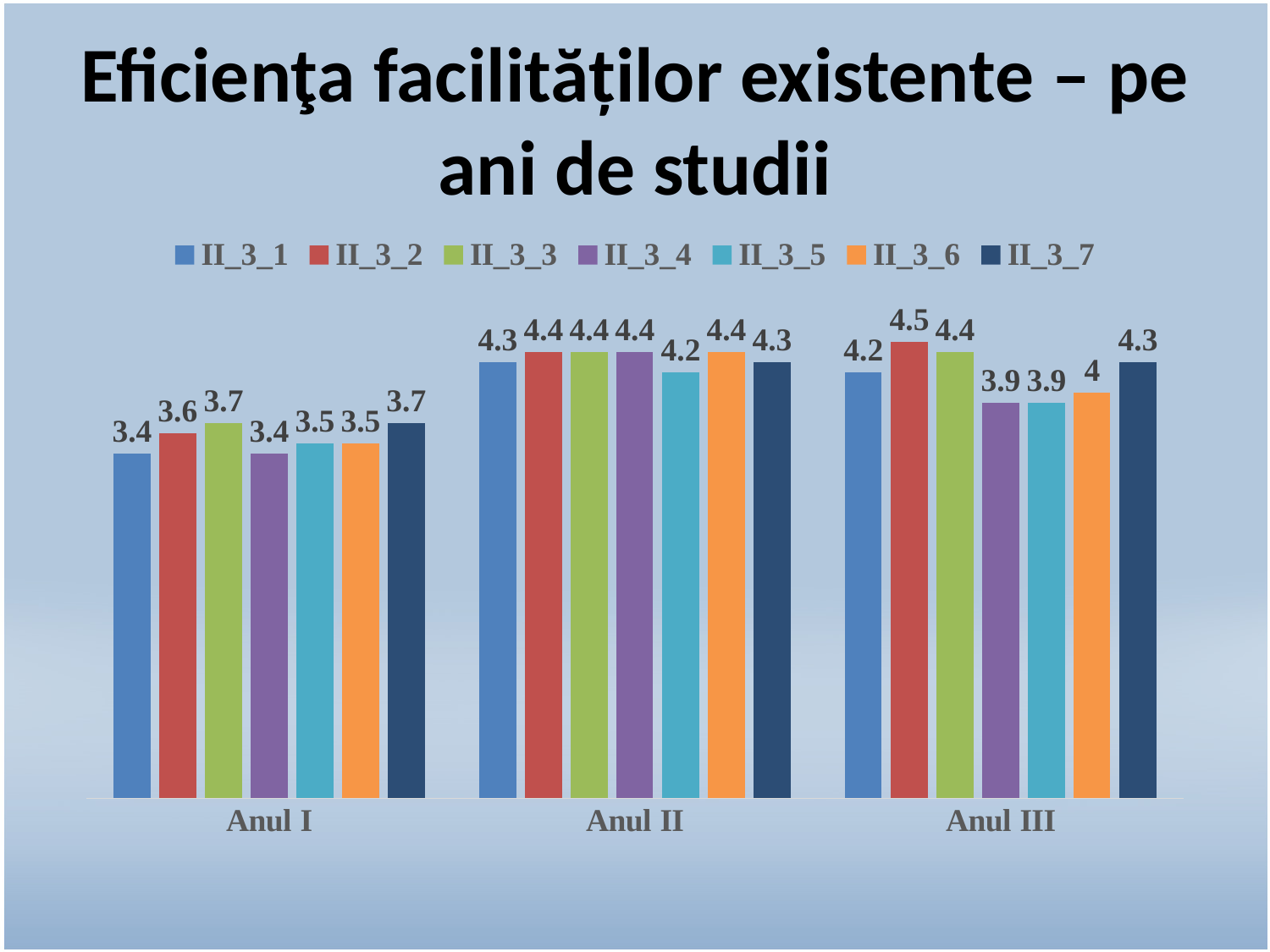
What kind of chart is shown on the slide? Bar chart Which series has the lowest value in Anul II? II_3_5 How many series does the legend list? 7 What is the value for II_3_1 in Anul I? 3.4 Which series has the highest value in Anul III? II_3_2 What is the value for II_3_5 in Anul II? 4.2 What is the difference between the II_3_2 value in Anul III and the II_3_2 value in Anul I? 0.9 What is the value for II_3_7 in Anul III? 4.3 What is the value for II_3_6 in Anul III? 4 Which is larger: the II_3_4 value in Anul II or the II_3_4 value in Anul III? Anul II What colour represents the II_3_6 series in the legend? Orange How many categories are shown on the x axis? 3